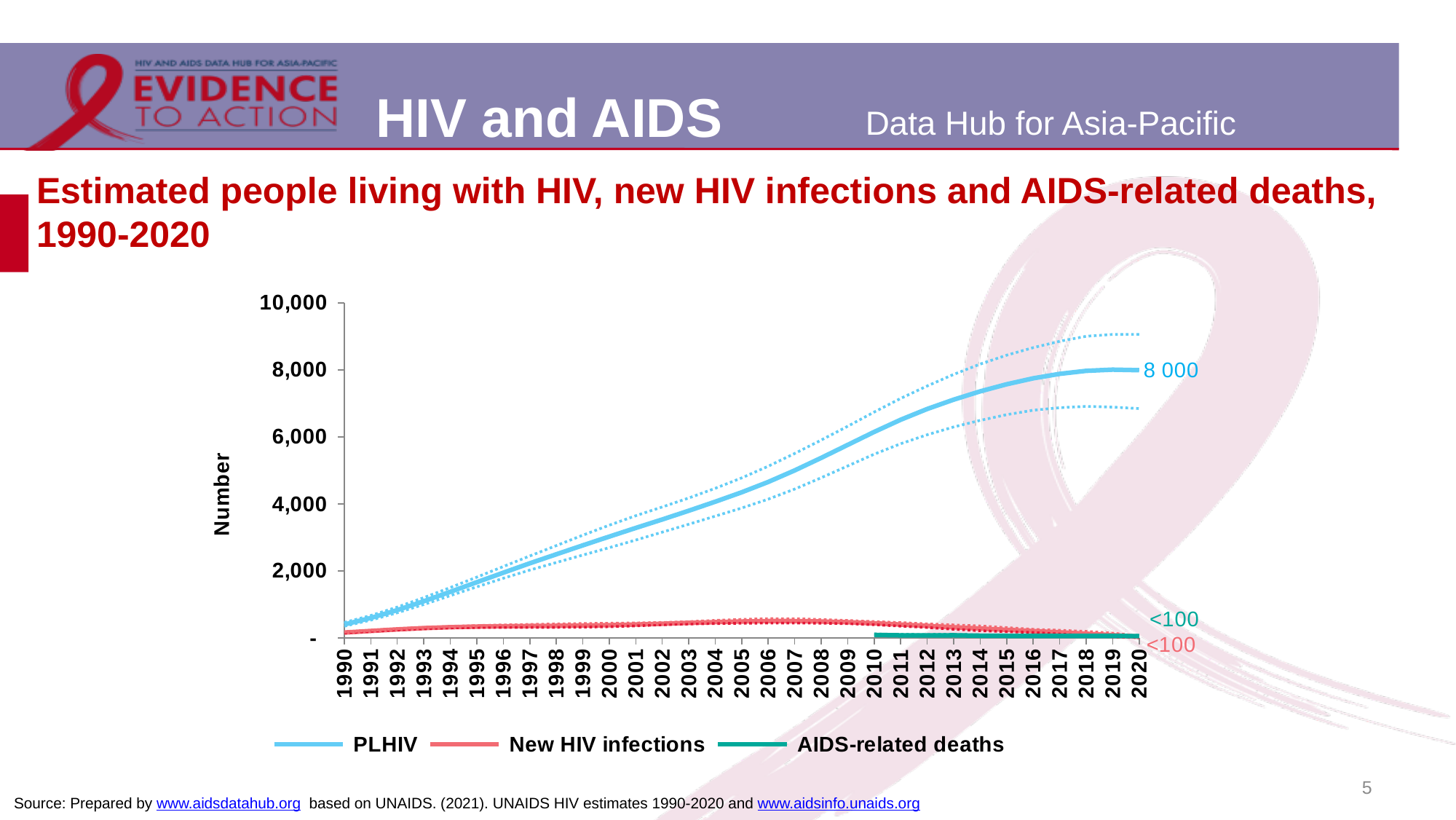
What kind of chart is shown on the slide? line chart In 2020, which is larger: PLHIV or new HIV infections? PLHIV What is the labelled value for AIDS-related deaths in 2020? <100 Which series has the highest value in 2020? PLHIV What is the labelled value for new HIV infections in 2020? <100 Does the PLHIV line rise or fall from 1990 to 2020? rise Is the value for PLHIV in 2000 greater or less than 4,000? less What is the title of the y axis? Number How many series does the legend list? 3 What is the labelled value for PLHIV in 2020? 8 000 How many years are shown on the x axis? 31 Is the value for PLHIV in 2010 greater or less than 4,000? greater